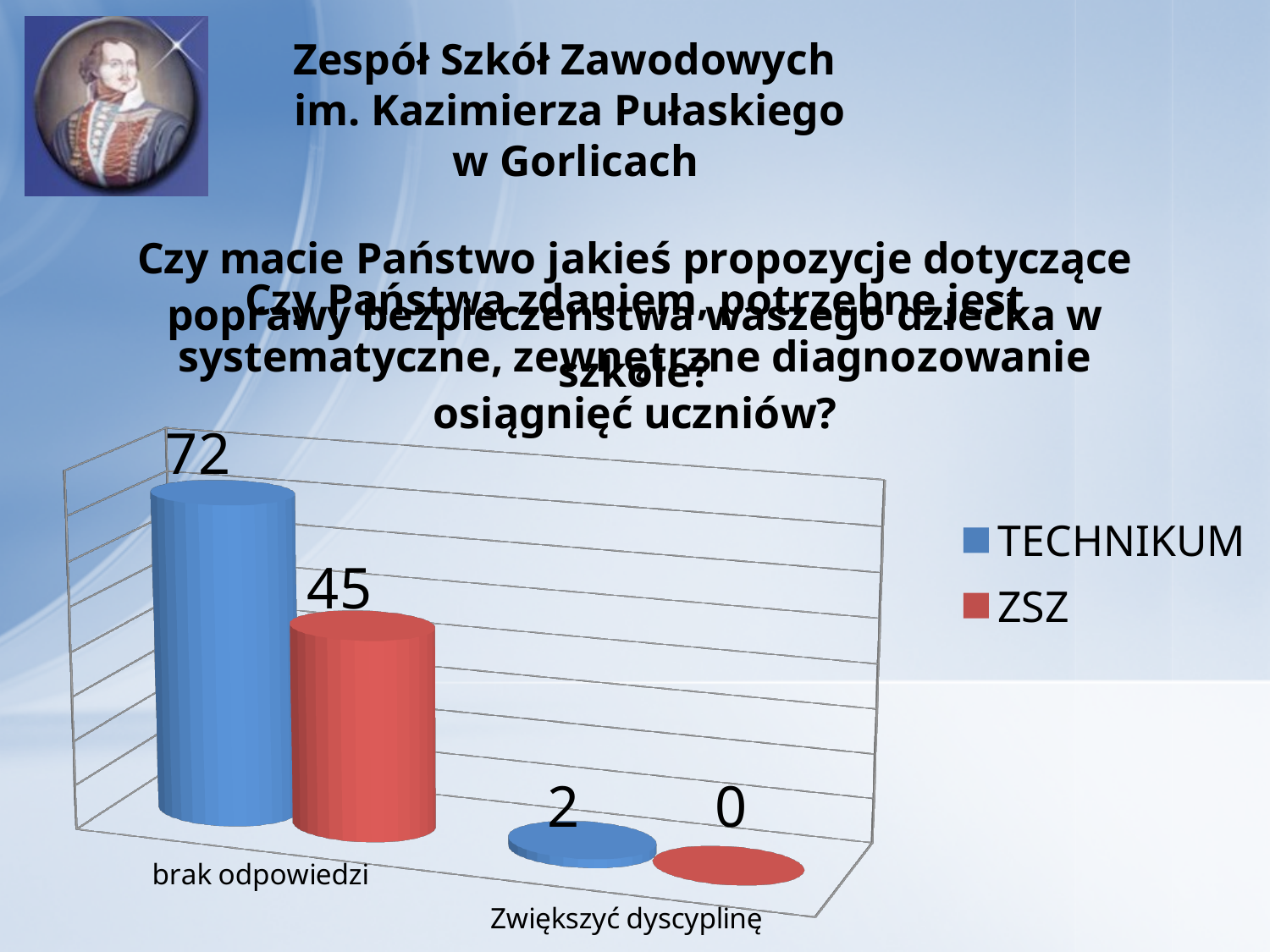
What is the ZSZ value for "Zwiększyć dyscyplinę"? 0 For "brak odpowiedzi", which series has the larger value, TECHNIKUM or ZSZ? TECHNIKUM What is the TECHNIKUM value for "Zwiększyć dyscyplinę"? 2 How many series does the legend list? 2 Which category has the highest TECHNIKUM value? brak odpowiedzi What kind of chart is shown on the slide? bar chart What is the ZSZ value for "brak odpowiedzi"? 45 What is the difference between the TECHNIKUM and ZSZ values for "brak odpowiedzi"? 27 How many categories are shown on the chart? 2 What is the TECHNIKUM value for "brak odpowiedzi"? 72 Which colour represents the ZSZ series in the chart? red Which category has the lowest ZSZ value? Zwiększyć dyscyplinę